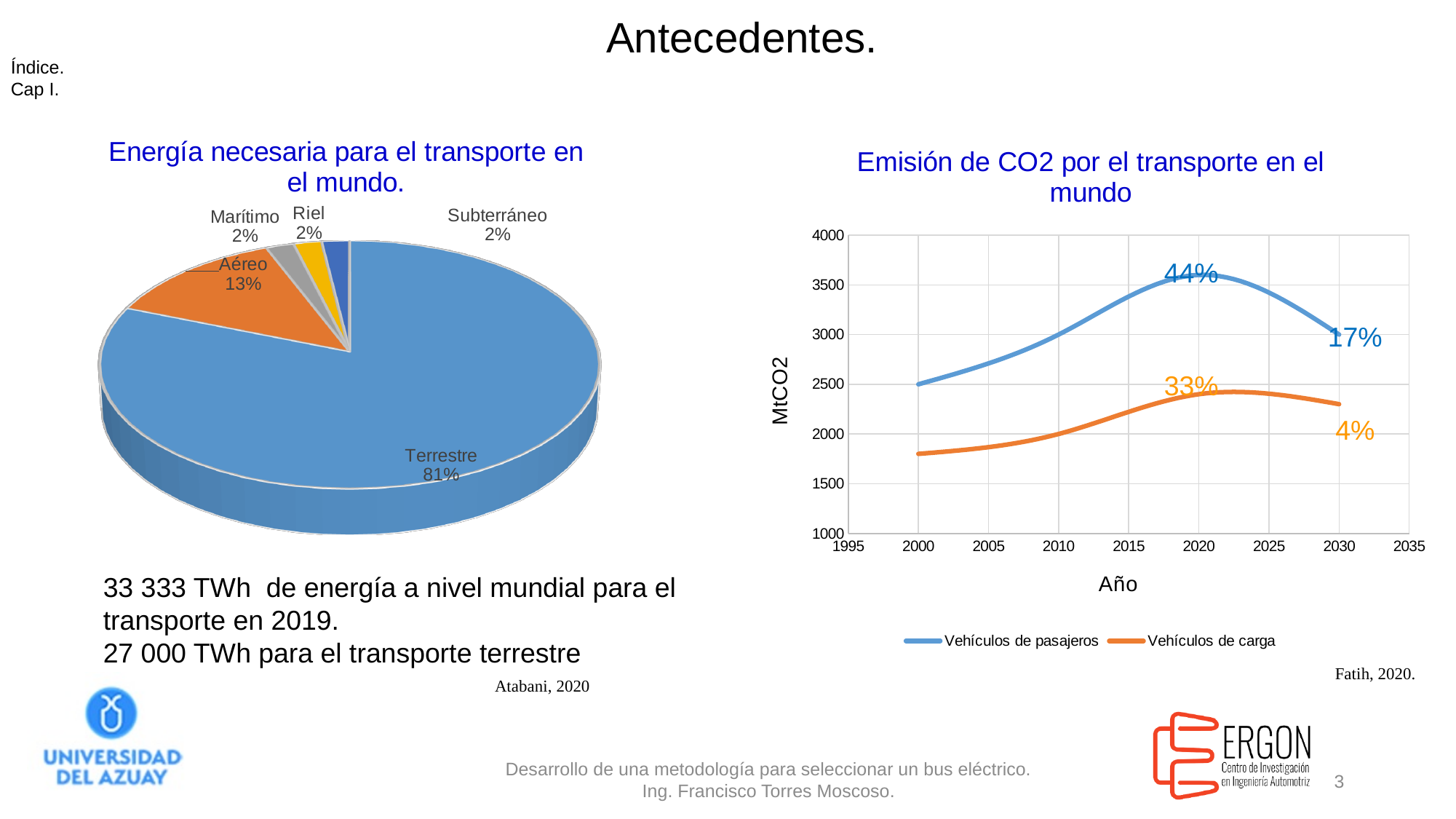
On the chart 'Emisión de CO2 por el transporte en el mundo', how many series does the legend list? 2 On the pie chart 'Energía necesaria para el transporte en el mundo', which category has the largest share? Terrestre What kind of chart is 'Emisión de CO2 por el transporte en el mundo'? Line chart On the pie chart 'Energía necesaria para el transporte en el mundo', what is the difference in percentage points between Terrestre and Aéreo? 68 On the chart 'Emisión de CO2 por el transporte en el mundo', is the value for Vehículos de carga in 2030 greater or less than 2000? greater On the pie chart 'Energía necesaria para el transporte en el mundo', how many categories are shown? 5 On the chart 'Emisión de CO2 por el transporte en el mundo', is the value for Vehículos de carga in 2000 greater or less than 2000? less On the pie chart 'Energía necesaria para el transporte en el mundo', what share does Terrestre have? 81% On the chart 'Emisión de CO2 por el transporte en el mundo', what is the label on the y axis? MtCO2 On the pie chart 'Energía necesaria para el transporte en el mundo', what share does Aéreo have? 13% On the pie chart 'Energía necesaria para el transporte en el mundo', which is larger, Aéreo or Marítimo? Aéreo What kind of chart is 'Energía necesaria para el transporte en el mundo'? Pie chart